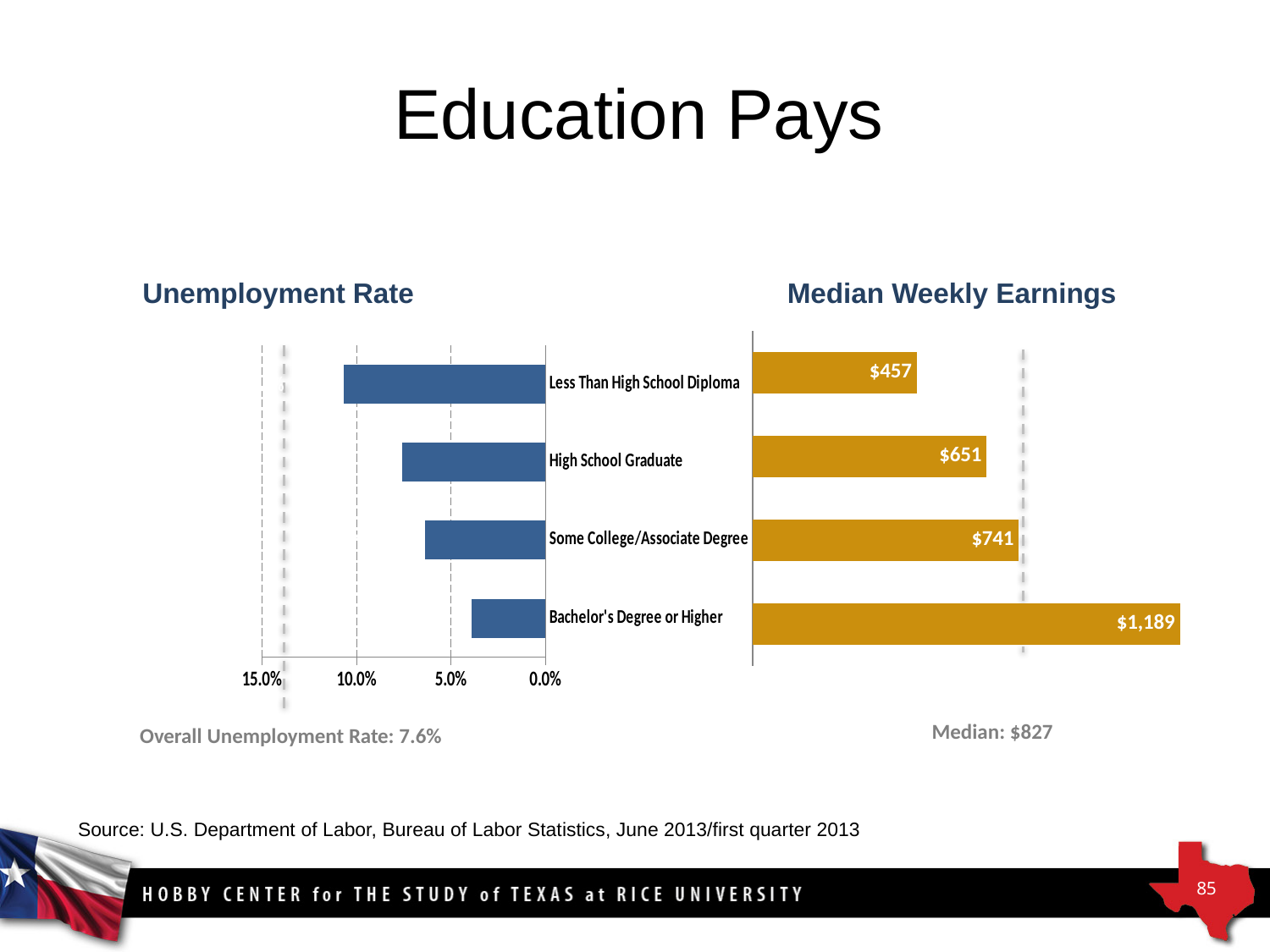
In the Unemployment Rate chart, which category has the lowest unemployment rate? Bachelor's Degree or Higher In the Unemployment Rate chart, is the value for Less Than High School Diploma greater or less than 10.0%? greater In the Unemployment Rate chart, which category has the highest unemployment rate? Less Than High School Diploma In the Median Weekly Earnings chart, which is larger: Some College/Associate Degree or Less Than High School Diploma? Some College/Associate Degree In the Unemployment Rate chart, is the value for Bachelor's Degree or Higher greater or less than 5.0%? less In the Median Weekly Earnings chart, what is the value for High School Graduate? $651 In the Median Weekly Earnings chart, which category has the lowest median weekly earnings? Less Than High School Diploma In the Median Weekly Earnings chart, which category has the highest median weekly earnings? Bachelor's Degree or Higher In the Median Weekly Earnings chart, what is the difference between Some College/Associate Degree and High School Graduate? $90 In the Median Weekly Earnings chart, what is the value for Less Than High School Diploma? $457 How many education categories are shown in the Median Weekly Earnings chart? 4 In the Median Weekly Earnings chart, what is the value for Bachelor's Degree or Higher? $1,189